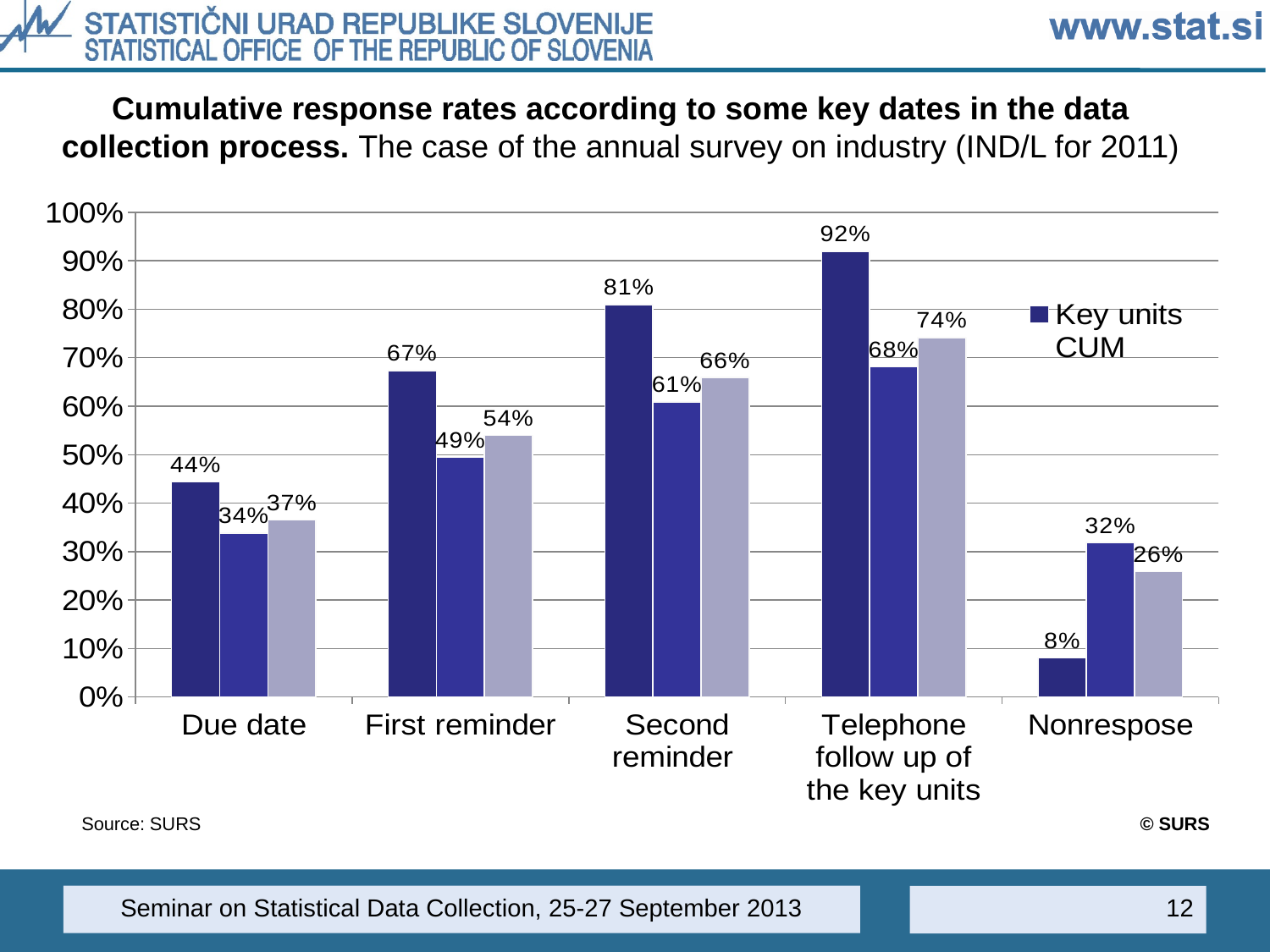
Does the Key units CUM value rise or fall from Due date to Telephone follow up of the key units? rise At which category is the Key units CUM value highest? Telephone follow up of the key units How many categories are shown on the x axis? 5 What is the difference between the Key units CUM values at Second reminder and First reminder? 14 percentage points What is the Key units CUM value at Due date? 44% Which has a larger Key units CUM value, First reminder or Second reminder? Second reminder What kind of chart is shown on the slide? bar chart Is the Key units CUM value at Nonrespose greater or less than 10%? less At which category is the Key units CUM value lowest? Nonrespose What is the difference between the Key units CUM values at Telephone follow up of the key units and Due date? 48 percentage points What is the highest value shown in the Nonrespose group? 32% What is the Key units CUM value at Telephone follow up of the key units? 92%